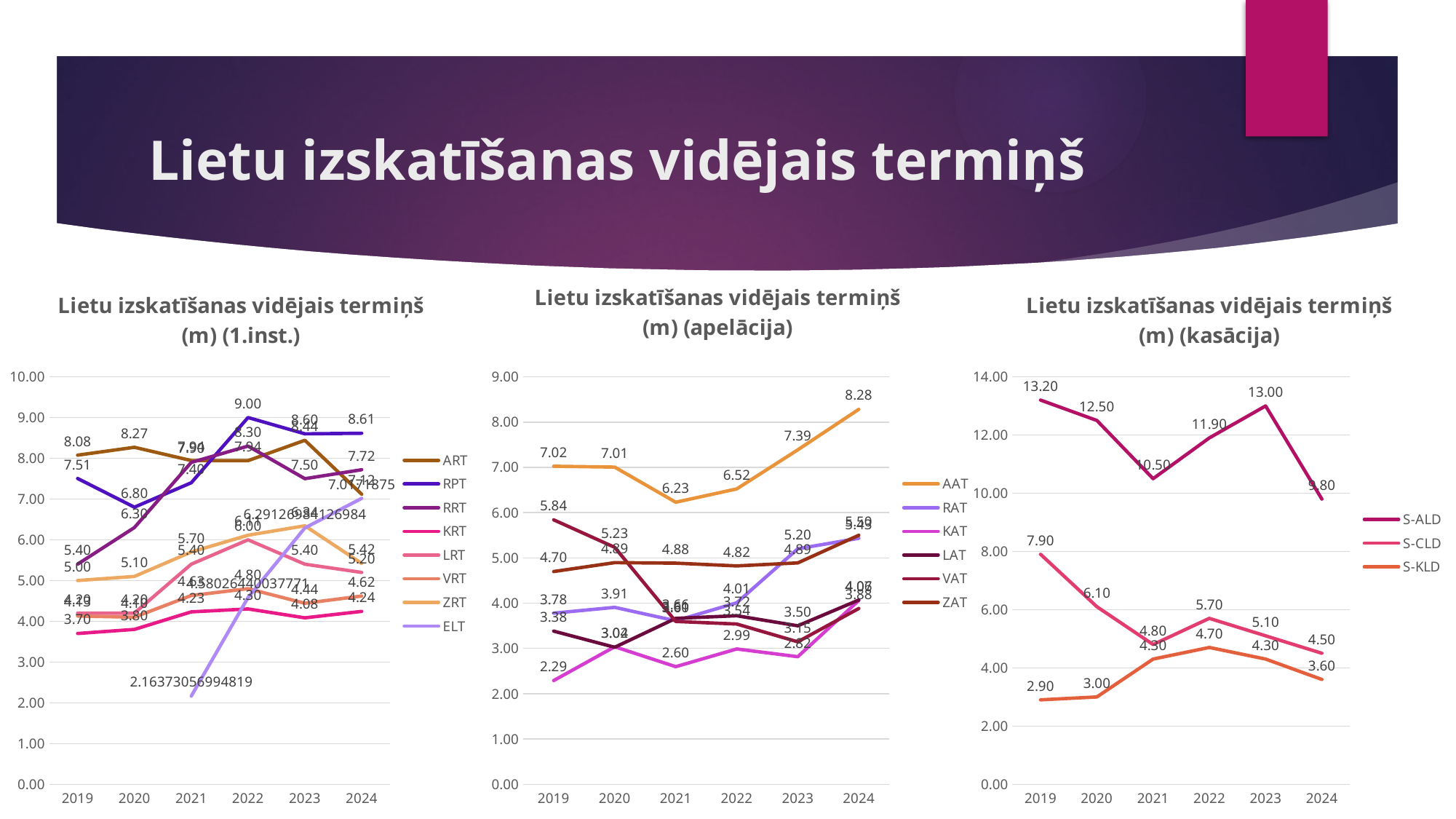
What kind of chart is the chart titled 'Lietu izskatīšanas vidējais termiņš (m) (1.inst.)'? line chart In the chart titled 'Lietu izskatīšanas vidējais termiņš (m) (kasācija)', what is the value for S-ALD in 2019? 13.20 In the chart titled 'Lietu izskatīšanas vidējais termiņš (m) (apelācija)', what is the value for AAT in 2024? 8.28 In the chart titled 'Lietu izskatīšanas vidējais termiņš (m) (apelācija)', how many series does the legend list? 6 In the chart titled 'Lietu izskatīšanas vidējais termiņš (m) (1.inst.)', what is the value for RPT in 2022? 9.00 In the chart titled 'Lietu izskatīšanas vidējais termiņš (m) (apelācija)', in which year is AAT lowest? 2021 In the chart titled 'Lietu izskatīšanas vidējais termiņš (m) (1.inst.)', is the value for ELT in 2021 greater or less than 3.00? less In the chart titled 'Lietu izskatīšanas vidējais termiņš (m) (kasācija)', what is the value for S-KLD in 2022? 4.70 In the chart titled 'Lietu izskatīšanas vidējais termiņš (m) (kasācija)', how many series does the legend list? 3 In the chart titled 'Lietu izskatīšanas vidējais termiņš (m) (kasācija)', what is the difference between S-CLD in 2019 and S-CLD in 2024? 3.40 In the chart titled 'Lietu izskatīšanas vidējais termiņš (m) (apelācija)', which is larger in 2019: VAT or ZAT? VAT In the chart titled 'Lietu izskatīšanas vidējais termiņš (m) (kasācija)', in which year is S-ALD lowest? 2024